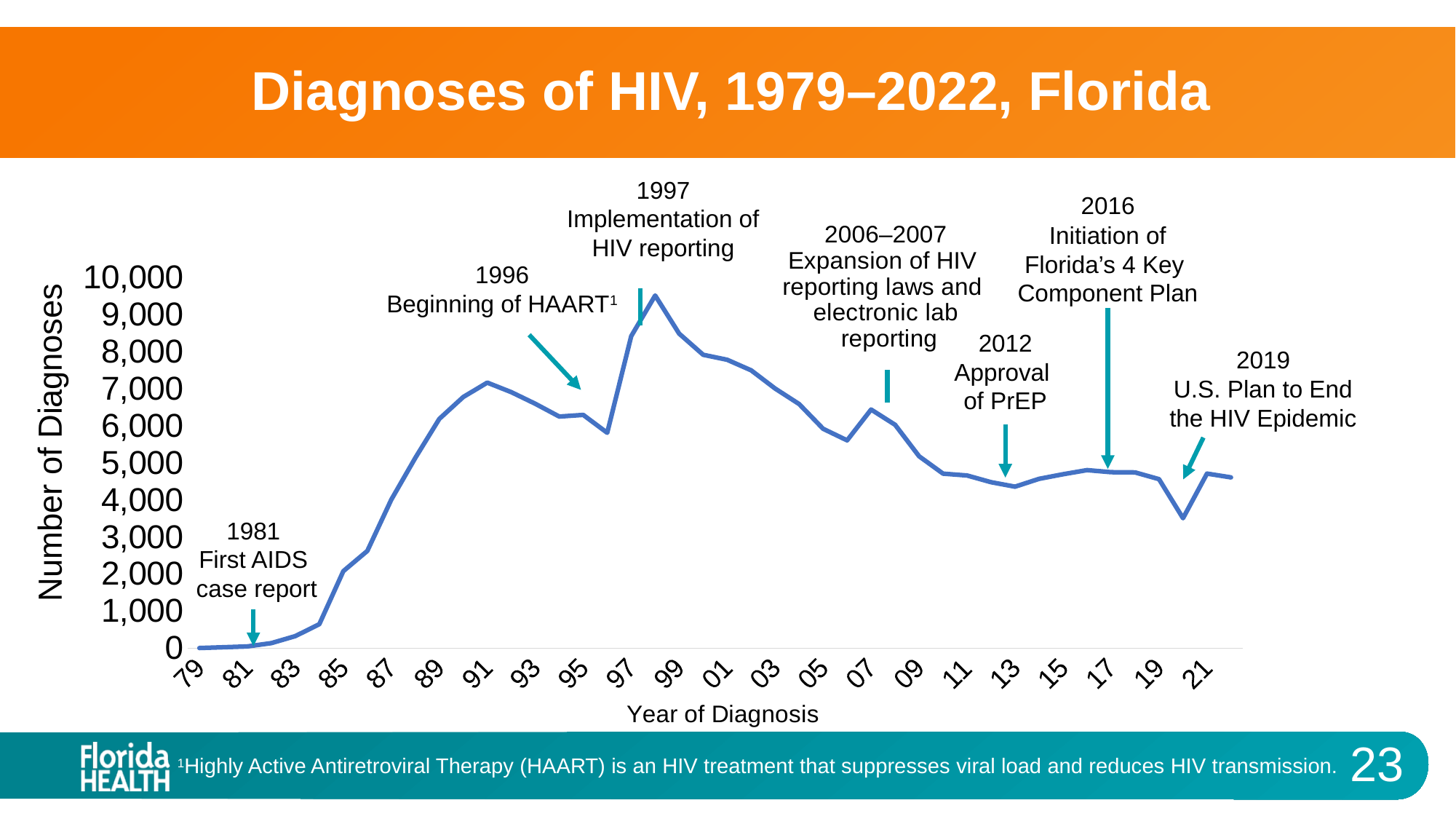
Is the value for 1983 greater or less than 1,000? less Is the value for 1998 greater or less than 9,000? greater Which year has more diagnoses, 1991 or 2011? 1991 In which year does the number of diagnoses reach its highest point? 1998 In which year is the number of diagnoses lowest? 1979 Is the value for 1989 greater or less than 5,000? greater What is the label of the y axis? Number of Diagnoses What kind of chart is shown on the slide? line chart Do the number of diagnoses rise or fall from 1998 to 2013? fall What is the title of the chart? Diagnoses of HIV, 1979–2022, Florida